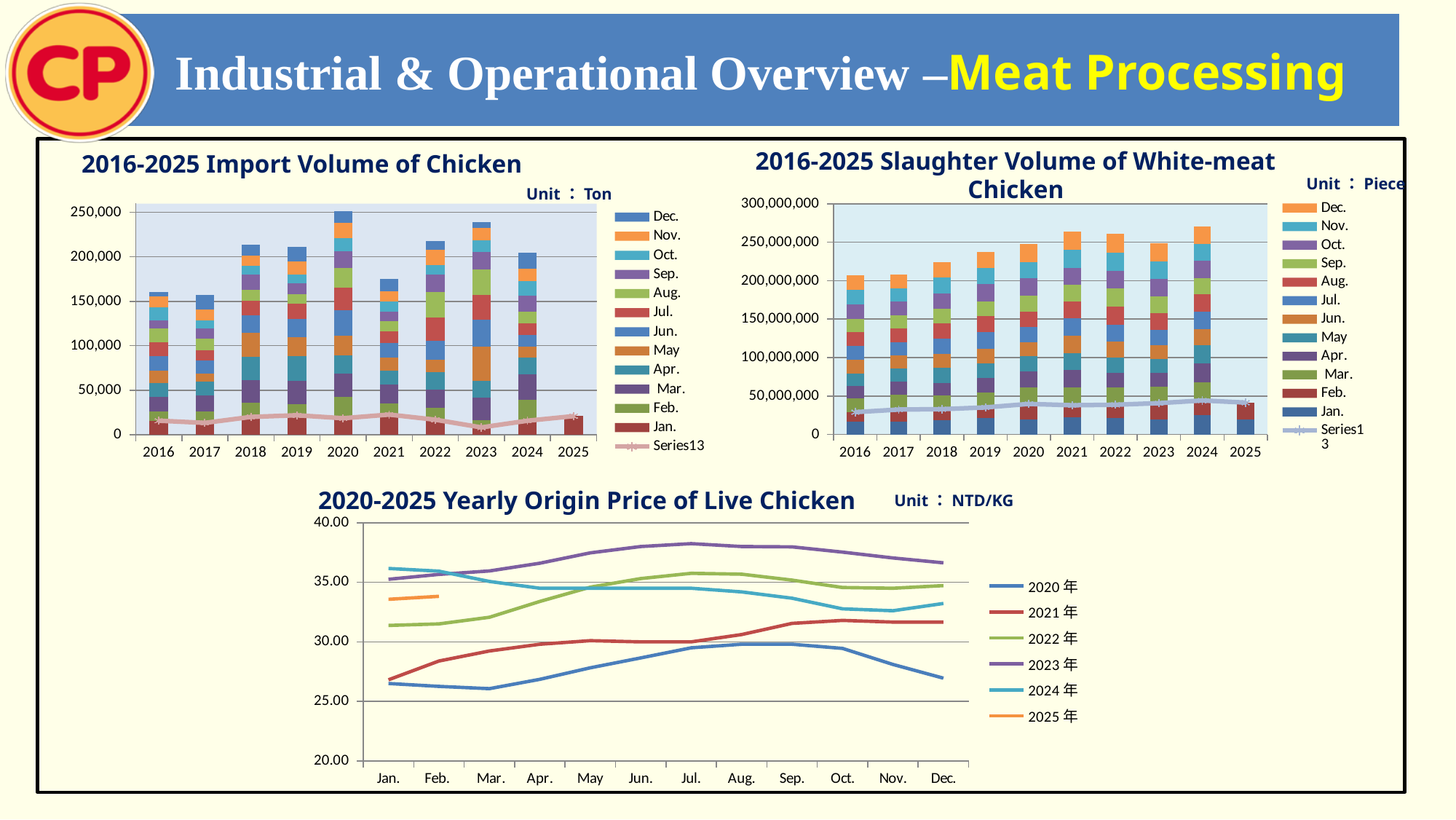
How many series does the legend of the '2020-2025 Yearly Origin Price of Live Chicken' chart list? 6 In the '2020-2025 Yearly Origin Price of Live Chicken' chart, is the 2020 value for Dec. greater or less than 30.00? less In the '2016-2025 Slaughter Volume of White-meat Chicken' chart, which year has the lowest total? 2025 In the '2016-2025 Slaughter Volume of White-meat Chicken' chart, is the total for 2024 greater or less than 250,000,000? greater In the '2016-2025 Import Volume of Chicken' chart, is the total for 2021 greater or less than 200,000? less In the '2016-2025 Import Volume of Chicken' chart, which year has the highest total import volume? 2020 How many years are shown on the x axis of the '2016-2025 Import Volume of Chicken' chart? 10 What type of chart is the '2016-2025 Import Volume of Chicken' chart? combination stacked bar and line chart In the '2020-2025 Yearly Origin Price of Live Chicken' chart, which year's line is the highest in July? 2023 What unit is stated for the '2016-2025 Slaughter Volume of White-meat Chicken' chart? Piece